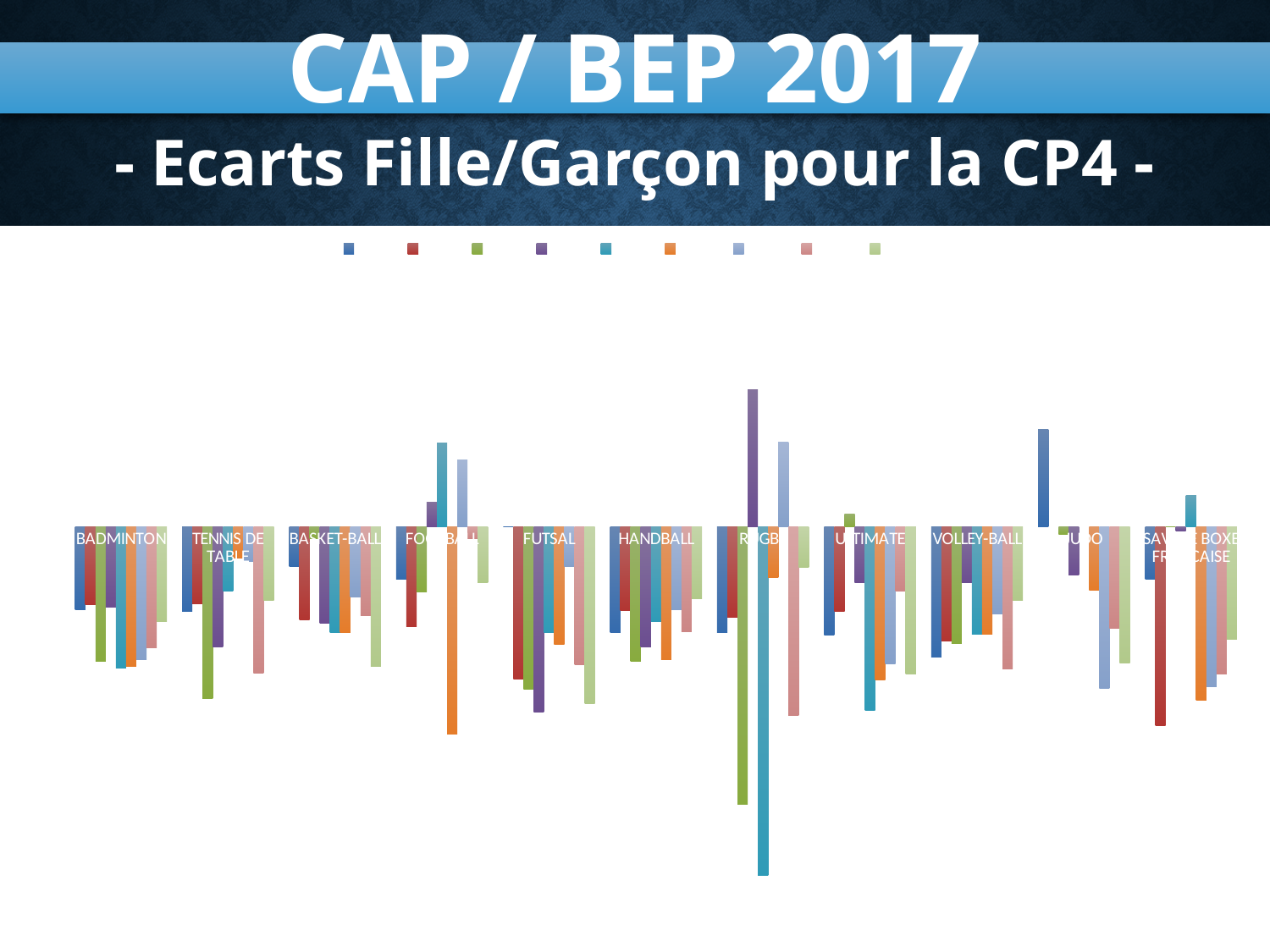
How many categories are shown along the x axis of the chart? 11 What is the last category label on the right of the x axis? SAVATE BOXE FRANCAISE Which category comes immediately after HANDBALL on the x axis? RUGBY Which category contains the longest bar below the horizontal axis? RUGBY Do most of the bars in the chart extend above or below the horizontal axis? below What kind of chart is shown on the slide? bar chart Which category comes immediately before JUDO on the x axis? VOLLEY-BALL Which category contains the tallest bar above the horizontal axis? RUGBY What is the first category label on the left of the x axis? BADMINTON What is the title of the slide containing the chart? CAP / BEP 2017 - Ecarts Fille/Garçon pour la CP4 - How many series does the legend list? 9